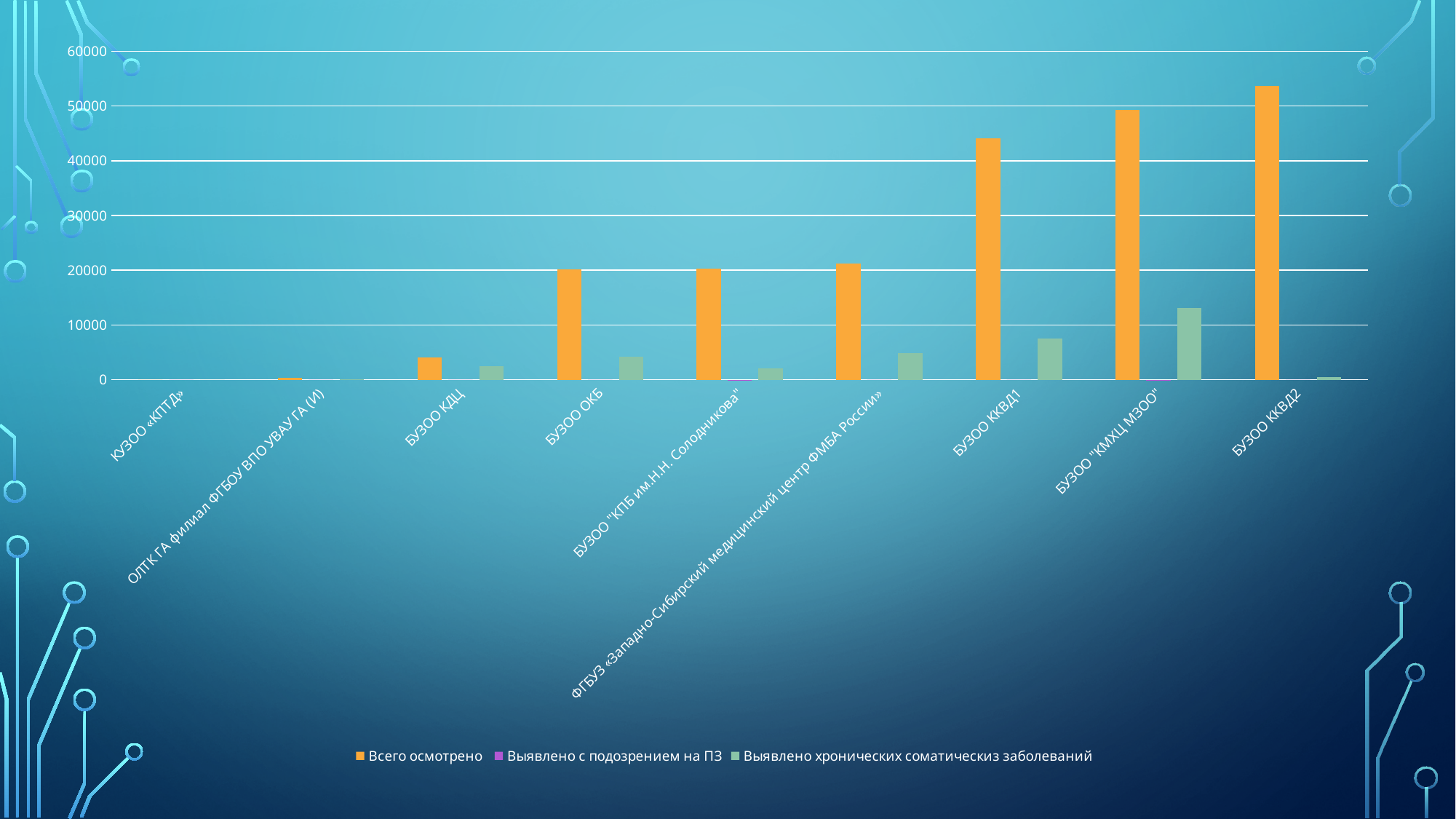
Is the "Всего осмотрено" value for БУЗОО ККВД1 greater or less than 40000? greater What kind of chart is shown on the slide? bar chart How many series does the legend list? 3 Which has the larger "Всего осмотрено" value, БУЗОО ККВД1 or БУЗОО ККВД2? БУЗОО ККВД2 Which category has the highest value for "Выявлено хронических соматическиз заболеваний"? БУЗОО "КМХЦ МЗОО" How many categories are shown on the x axis? 9 Is the "Всего осмотрено" value for БУЗОО КДЦ greater or less than 10000? less Do the "Всего осмотрено" values generally rise or fall from left to right along the x axis? rise Is the "Выявлено хронических соматическиз заболеваний" value for БУЗОО "КМХЦ МЗОО" greater or less than 10000? greater Which category has the highest value for "Всего осмотрено"? БУЗОО ККВД2 What colour are the bars for the "Всего осмотрено" series? orange